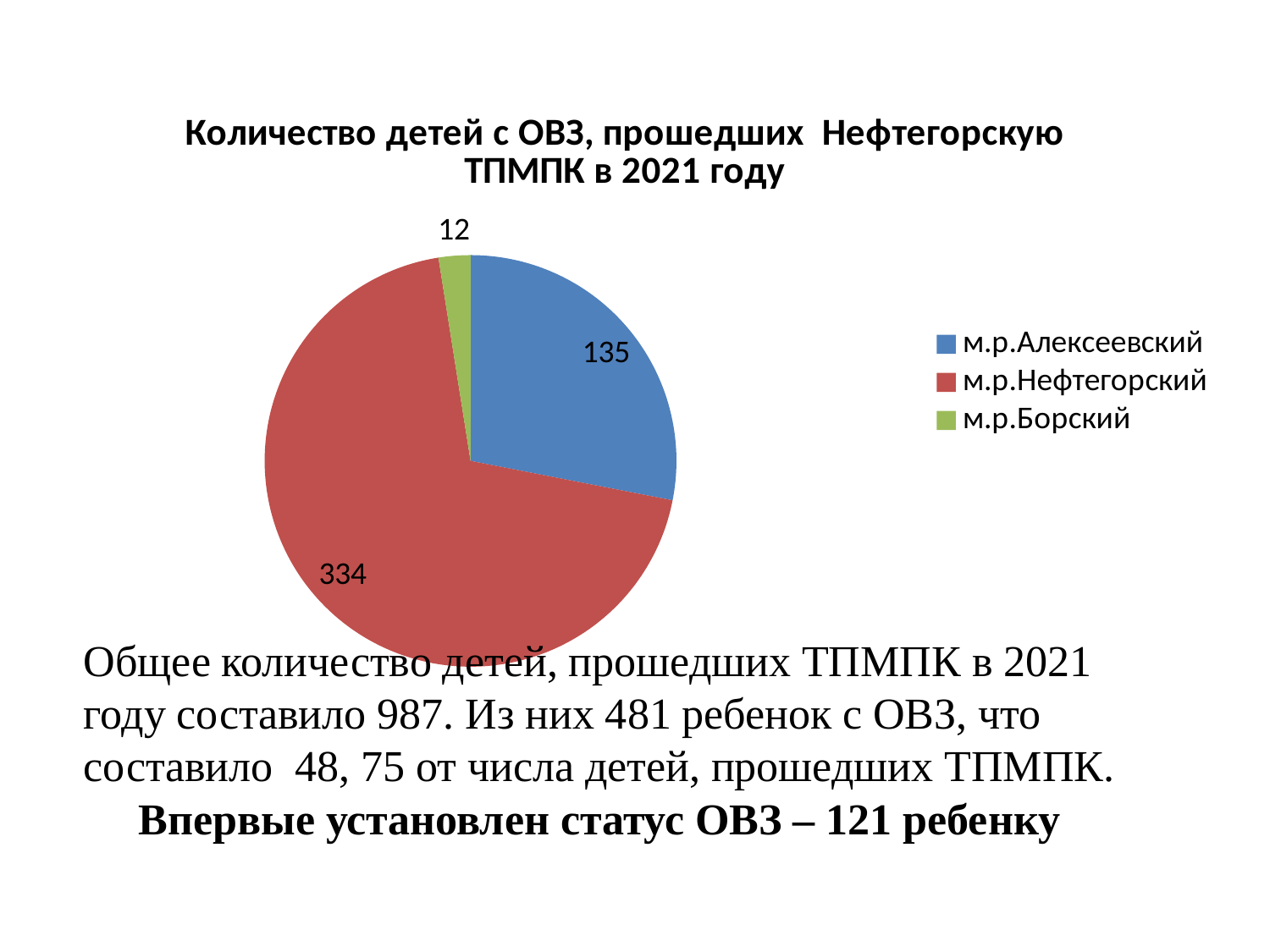
How many slices does the pie chart have? 3 What is the value for м.р.Борский? 12 What is the total of all slices in the pie chart? 481 What is the value for м.р.Нефтегорский? 334 Which district has the smallest slice of the pie? м.р.Борский Which is larger, the value for м.р.Алексеевский or the value for м.р.Борский? м.р.Алексеевский What is the difference between the values for м.р.Алексеевский and м.р.Борский? 123 Which district has the largest slice of the pie? м.р.Нефтегорский What is the difference between the values for м.р.Нефтегорский and м.р.Алексеевский? 199 What is the value for м.р.Алексеевский? 135 What type of chart is shown on the slide? pie chart What colour is the slice for м.р.Нефтегорский? red